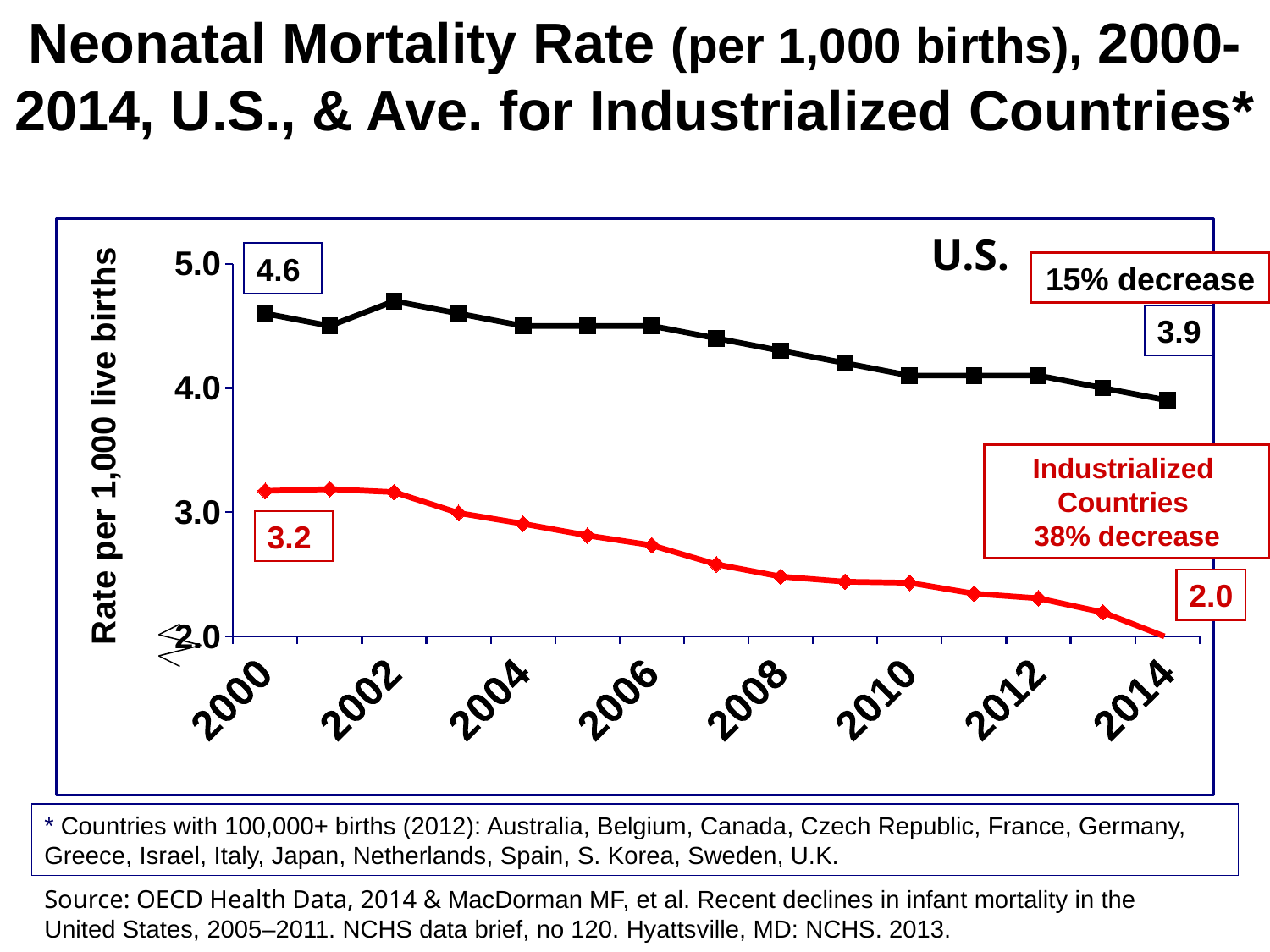
What is the difference between the U.S. rate in 2000 and the U.S. rate in 2014? 0.7 What was the average neonatal mortality rate for industrialized countries in 2000? 3.2 Which series has the higher neonatal mortality rate in 2014, the U.S. or the industrialized countries? U.S. By what percentage did the industrialized countries' neonatal mortality rate decrease from 2000 to 2014, according to the chart? 38% decrease What was the U.S. neonatal mortality rate in 2000? 4.6 What was the U.S. neonatal mortality rate in 2014? 3.9 Do the neonatal mortality rates for both series rise or fall from 2000 to 2014? fall What kind of chart is shown on the slide? line chart What is the difference between the U.S. rate and the industrialized countries' rate in 2000? 1.4 Is the U.S. neonatal mortality rate in 2008 greater or less than 4.0? greater What was the average neonatal mortality rate for industrialized countries in 2014? 2.0 By what percentage did the U.S. neonatal mortality rate decrease from 2000 to 2014, according to the chart? 15% decrease